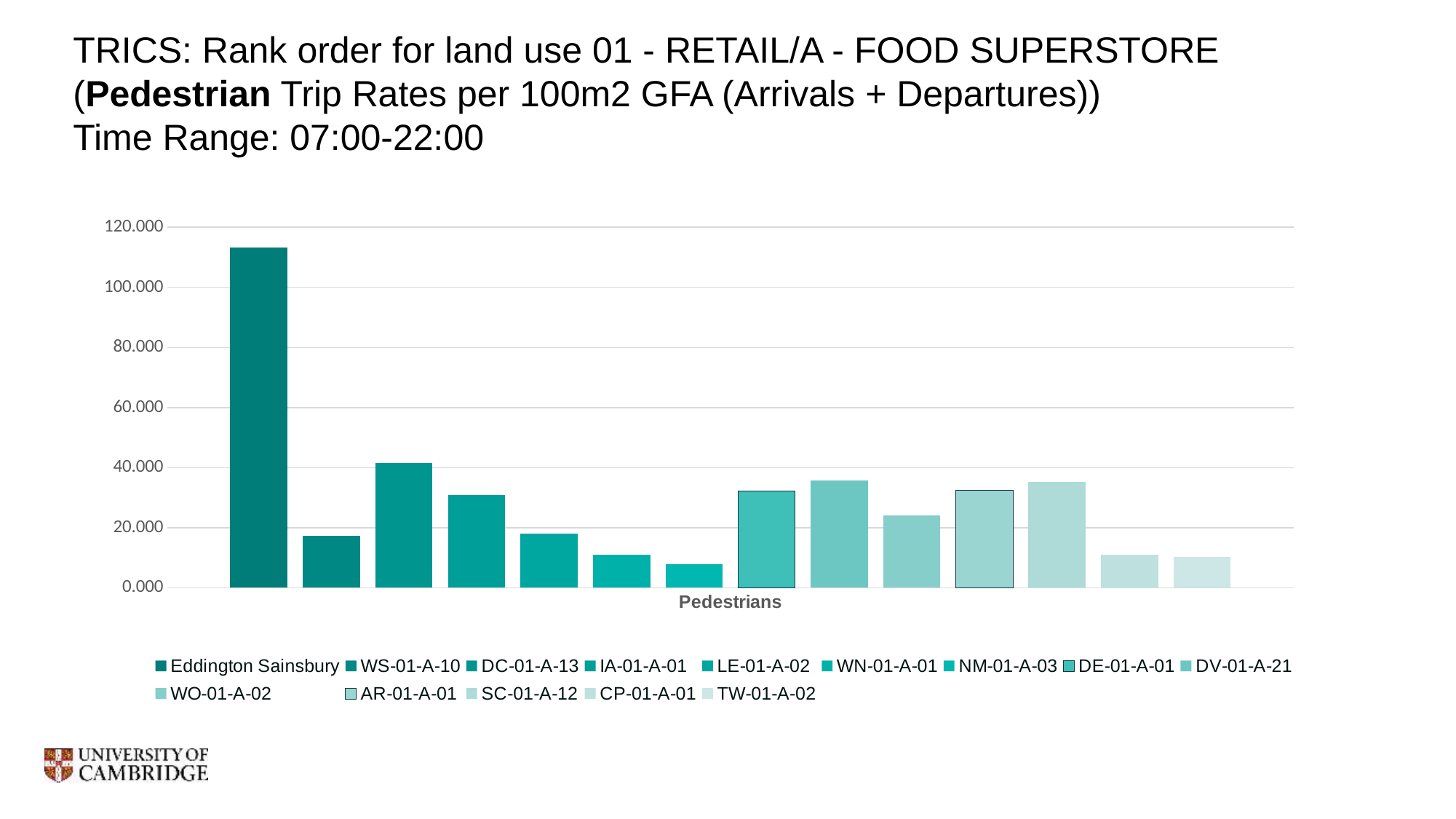
What is the label shown on the x axis of the chart? Pedestrians Is the value for NM-01-A-03 greater or less than 20.000? less Is the value for WS-01-A-10 greater or less than 20.000? less Is the value for Eddington Sainsbury greater or less than 100.000? greater Which is larger, the value for DC-01-A-13 or the value for DV-01-A-21? DC-01-A-13 Which is larger, the value for WS-01-A-10 or the value for WO-01-A-02? WO-01-A-02 Which series has the highest value in the chart? Eddington Sainsbury How many series does the legend list? 14 Which series has the lowest value in the chart? NM-01-A-03 What kind of chart is shown on the slide? bar chart What time range does the chart title state? 07:00-22:00